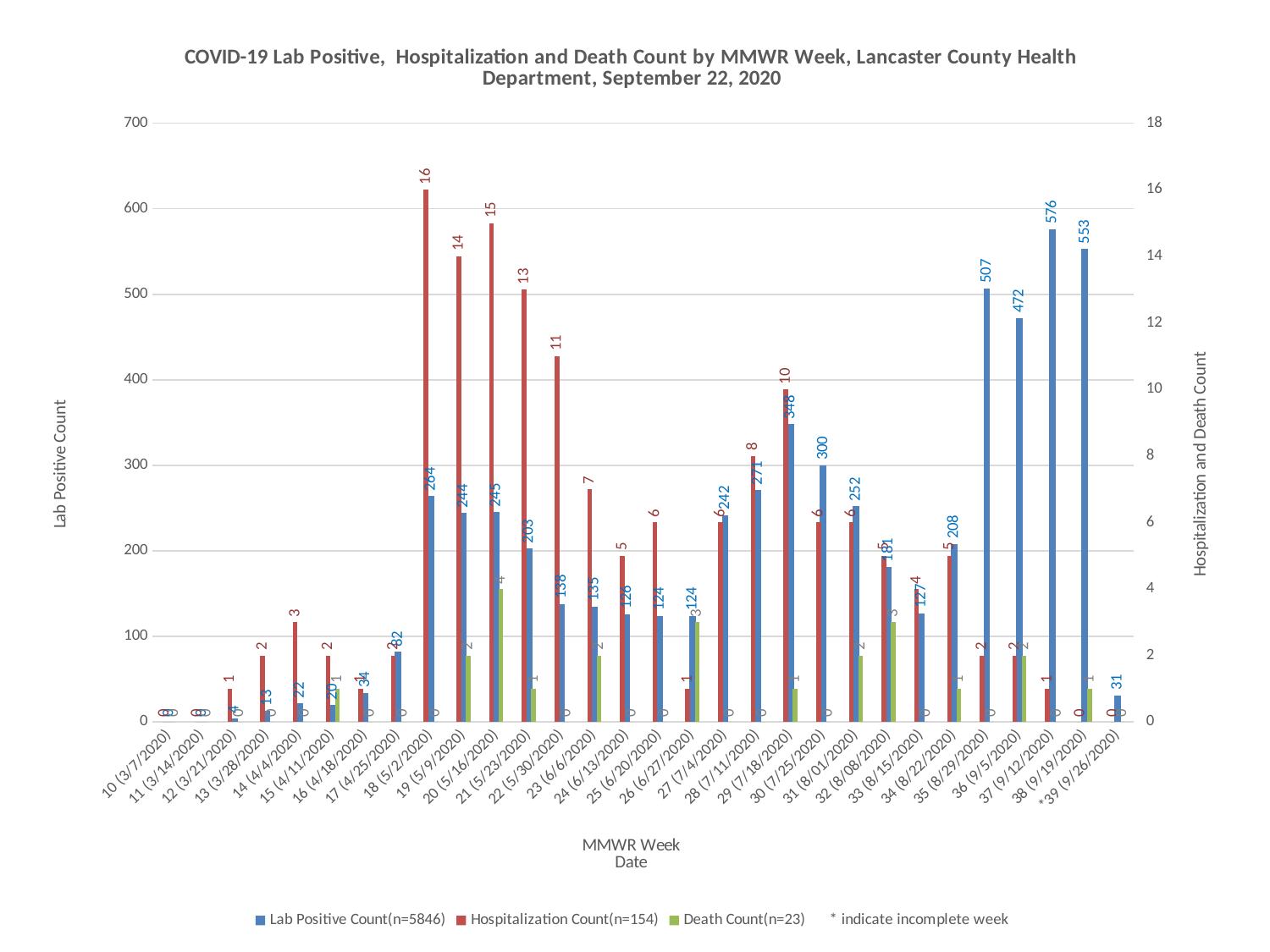
What is the Hospitalization Count for MMWR week 20 (5/16/2020)? 15 How many MMWR weeks are shown on the x axis? 30 How many series does the legend list? 3 Which MMWR week has the highest Hospitalization Count? 18 (5/2/2020) What is the difference between the Lab Positive Count for week 37 (9/12/2020) and week 38 (9/19/2020)? 23 What is the Death Count for MMWR week 20 (5/16/2020)? 4 Which MMWR week has the highest Lab Positive Count? 37 (9/12/2020) What is the Lab Positive Count for MMWR week 35 (8/29/2020)? 507 According to the legend, what does the asterisk (*) indicate? Incomplete week Is the Lab Positive Count for week 36 (9/5/2020) greater or less than 400? greater What kind of chart is shown on the slide? Bar chart Which week has a larger Lab Positive Count, week 29 (7/18/2020) or week 30 (7/25/2020)? 29 (7/18/2020)